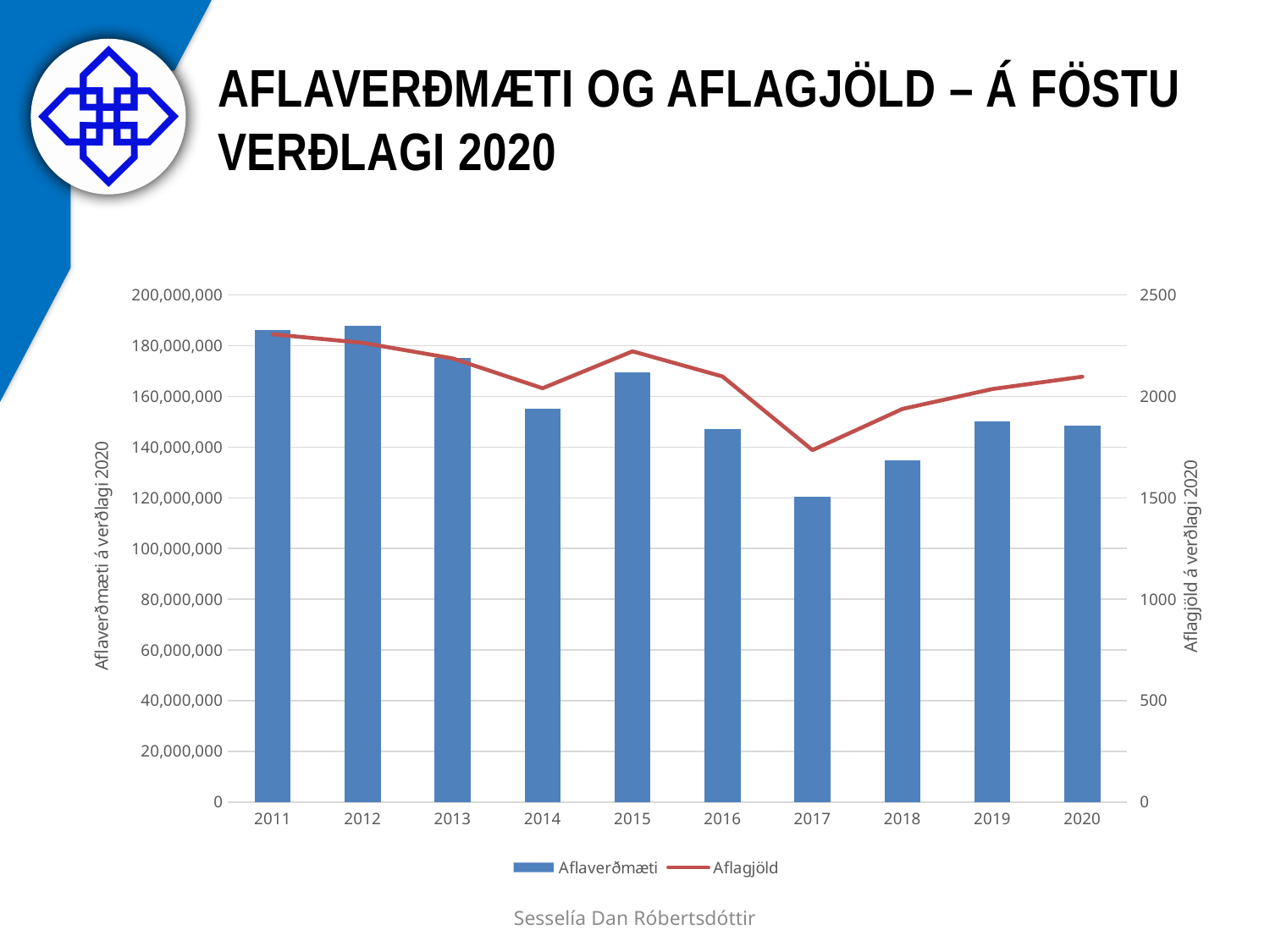
Is the Aflaverðmæti value for 2017 greater or less than 140,000,000? less Is the Aflagjöld value for 2011 greater or less than 2000? greater How many series does the chart legend list? 2 Is the Aflagjöld value for 2017 greater or less than 2000? less In which year does the Aflagjöld line reach its lowest point? 2017 Which series is drawn as a red line in the chart? Aflagjöld Do the Aflaverðmæti bars generally rise or fall from 2011 to 2017? fall Which year has the larger Aflaverðmæti bar, 2015 or 2016? 2015 What kind of chart is shown on the slide? A bar chart combined with a line chart Which year has the lowest Aflaverðmæti bar? 2017 How many years are shown on the x axis of the chart? 10